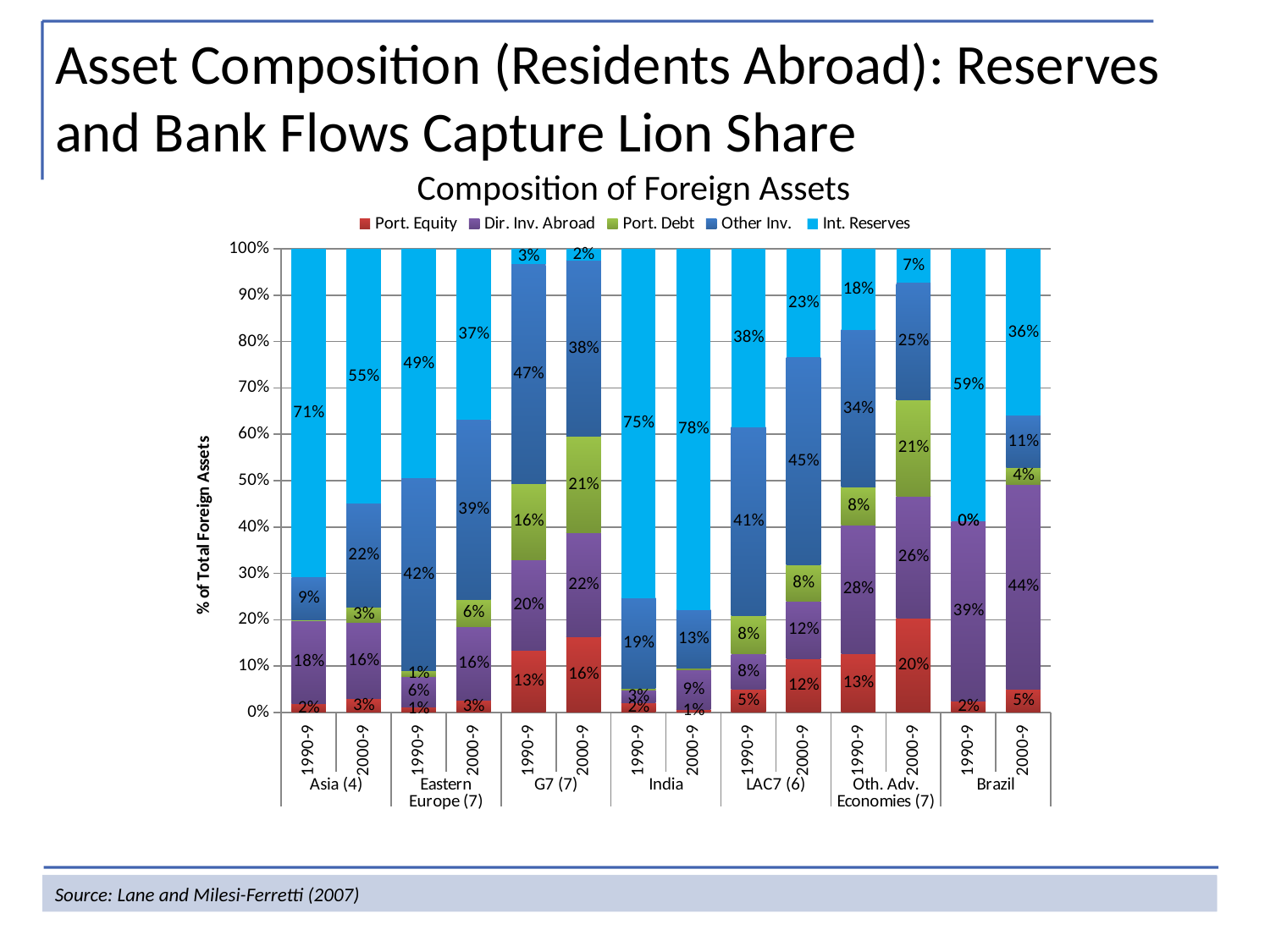
Which bar has the lowest Int. Reserves share? G7 (7) 2000-9 What is the Other Inv. share for G7 (7) in 1990-9? 47% What is the Port. Equity share for Oth. Adv. Economies (7) in 2000-9? 20% What is the Port. Debt share for G7 (7) in 2000-9? 21% What kind of chart is shown on the slide? Stacked bar chart Which is larger: the Other Inv. share for LAC7 (6) in 2000-9 or for Oth. Adv. Economies (7) in 1990-9? LAC7 (6) in 2000-9 How many series does the legend of the 'Composition of Foreign Assets' chart list? 5 By how many percentage points did the Int. Reserves share for Asia (4) change from 1990-9 (71%) to 2000-9 (55%)? 16 percentage points How many region groups are shown along the x axis? 7 What is the Dir. Inv. Abroad share for Brazil in 2000-9? 44% What is the Int. Reserves share for Asia (4) in 1990-9? 71% Which bar has the highest Int. Reserves share? India 2000-9